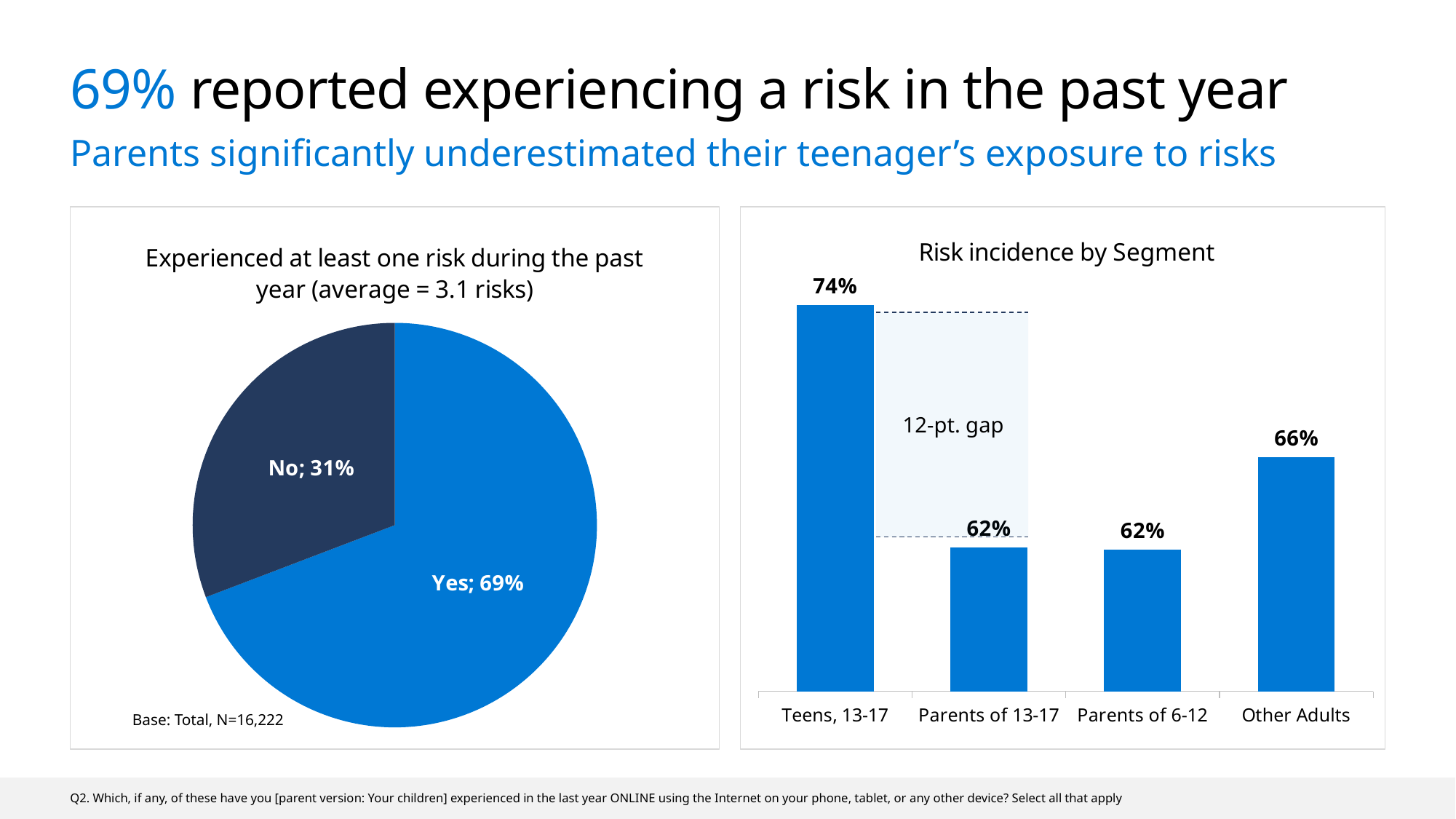
What type of chart is the chart on the left? pie chart In the 'Risk incidence by Segment' chart, what is the value for Other Adults? 66% How many segments are shown in the 'Risk incidence by Segment' chart? 4 In the 'Risk incidence by Segment' chart, what is the value for Teens, 13-17? 74% What is the title of the chart on the right? Risk incidence by Segment In the pie chart on the left, what share of respondents answered No? 31% In the 'Risk incidence by Segment' chart, what is the value for Parents of 6-12? 62% What type of chart is the 'Risk incidence by Segment' chart? bar chart In the 'Risk incidence by Segment' chart, which is larger: Other Adults or Parents of 6-12? Other Adults In the pie chart on the left, what share of respondents answered Yes? 69% In the 'Risk incidence by Segment' chart, what is the difference between Teens, 13-17 and Parents of 13-17? 12 percentage points In the 'Risk incidence by Segment' chart, which segment has the highest value? Teens, 13-17